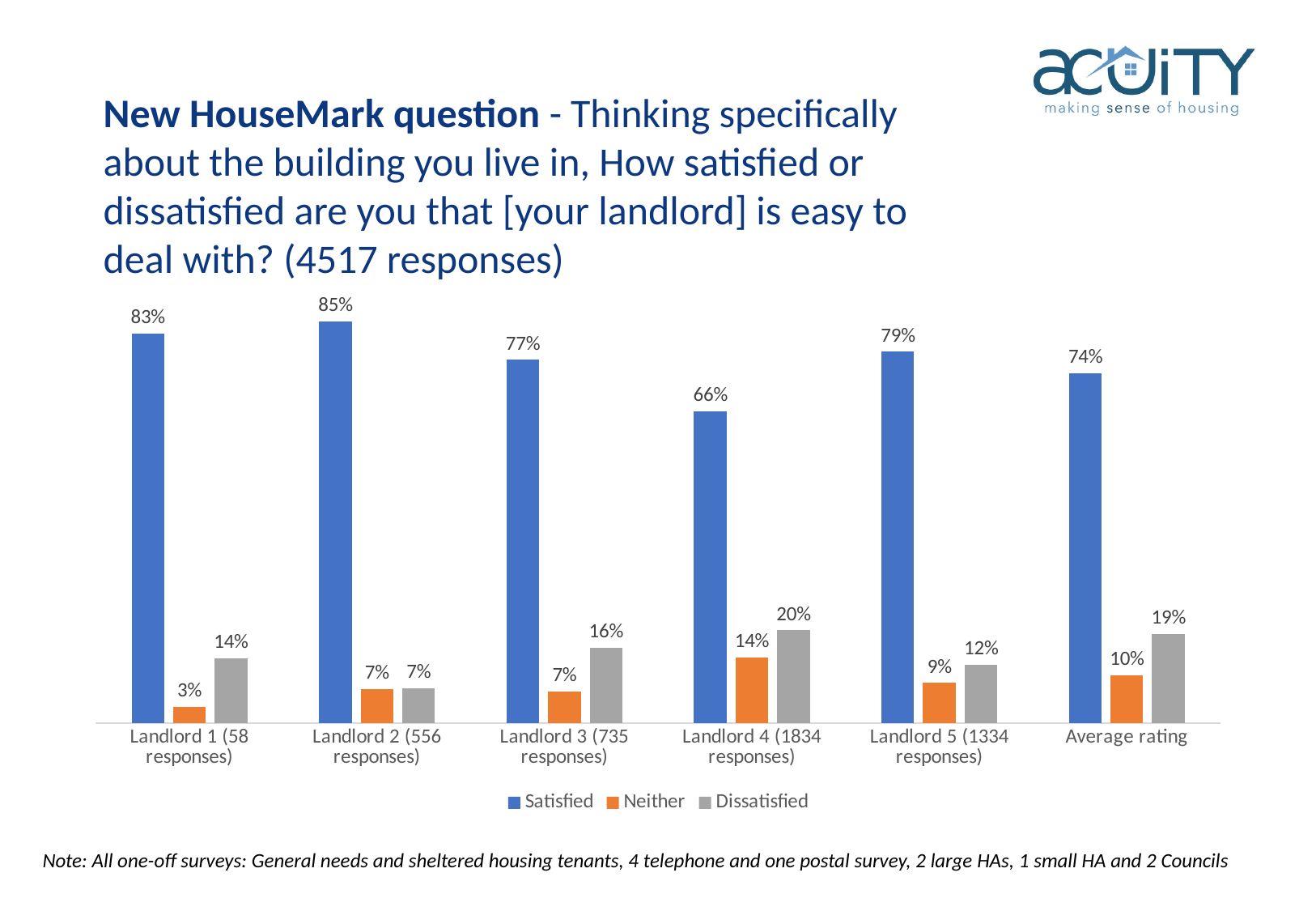
What is the total of the Satisfied, Neither and Dissatisfied values for Landlord 1 (58 responses)? 100% Which is larger: the Dissatisfied value for Landlord 3 (735 responses) or for Landlord 5 (1334 responses)? Landlord 3 (735 responses) What is the difference between the Satisfied values for Landlord 2 (556 responses) and Landlord 4 (1834 responses)? 19% What is the Satisfied value for Landlord 2 (556 responses)? 85% What kind of chart is shown on the slide? Bar chart Which category has the lowest Neither value? Landlord 1 (58 responses) How many series does the legend list? 3 What is the Dissatisfied value for Landlord 4 (1834 responses)? 20% Which colour represents the Neither series in the legend? Orange What is the Neither value for Average rating? 10% How many categories are shown on the x axis? 6 Which landlord has the highest Satisfied value? Landlord 2 (556 responses)